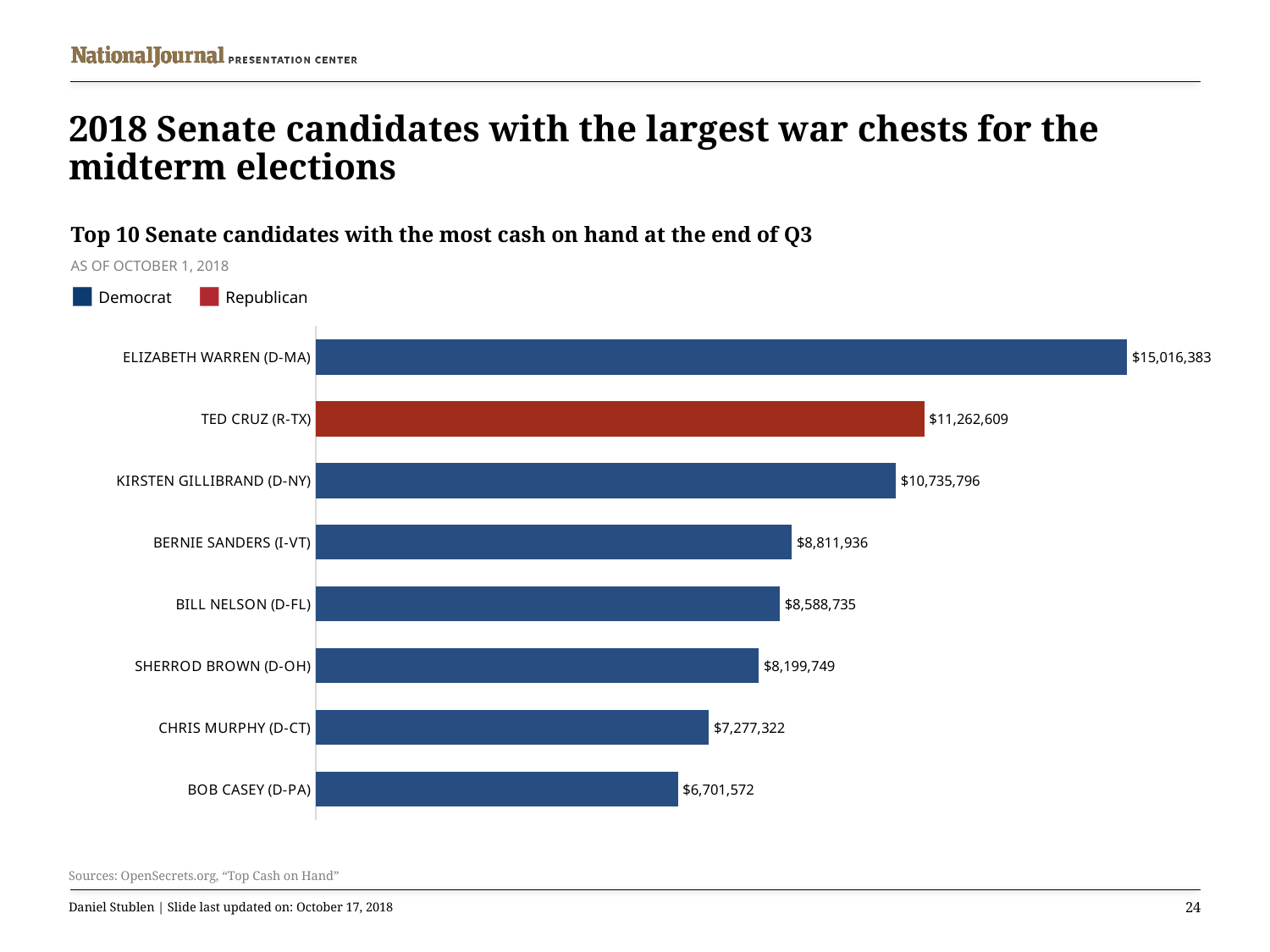
What is the cash on hand shown for Elizabeth Warren (D-MA)? $15,016,383 What is the cash on hand shown for Sherrod Brown (D-OH)? $8,199,749 How many candidates are shown in the chart? 8 How many entries does the legend list? 2 Which candidate has the smallest cash on hand in the chart? Bob Casey (D-PA) What kind of chart is shown on the slide? Bar chart Which candidate's bar is coloured red (Republican)? Ted Cruz (R-TX) Who has more cash on hand, Bernie Sanders (I-VT) or Bill Nelson (D-FL)? Bernie Sanders (I-VT) Which candidate has the largest cash on hand in the chart? Elizabeth Warren (D-MA) What is the difference in cash on hand between Elizabeth Warren (D-MA) and Ted Cruz (R-TX)? $3,753,774 What is the cash on hand shown for Ted Cruz (R-TX)? $11,262,609 What is the difference in cash on hand between Chris Murphy (D-CT) and Bob Casey (D-PA)? $575,750